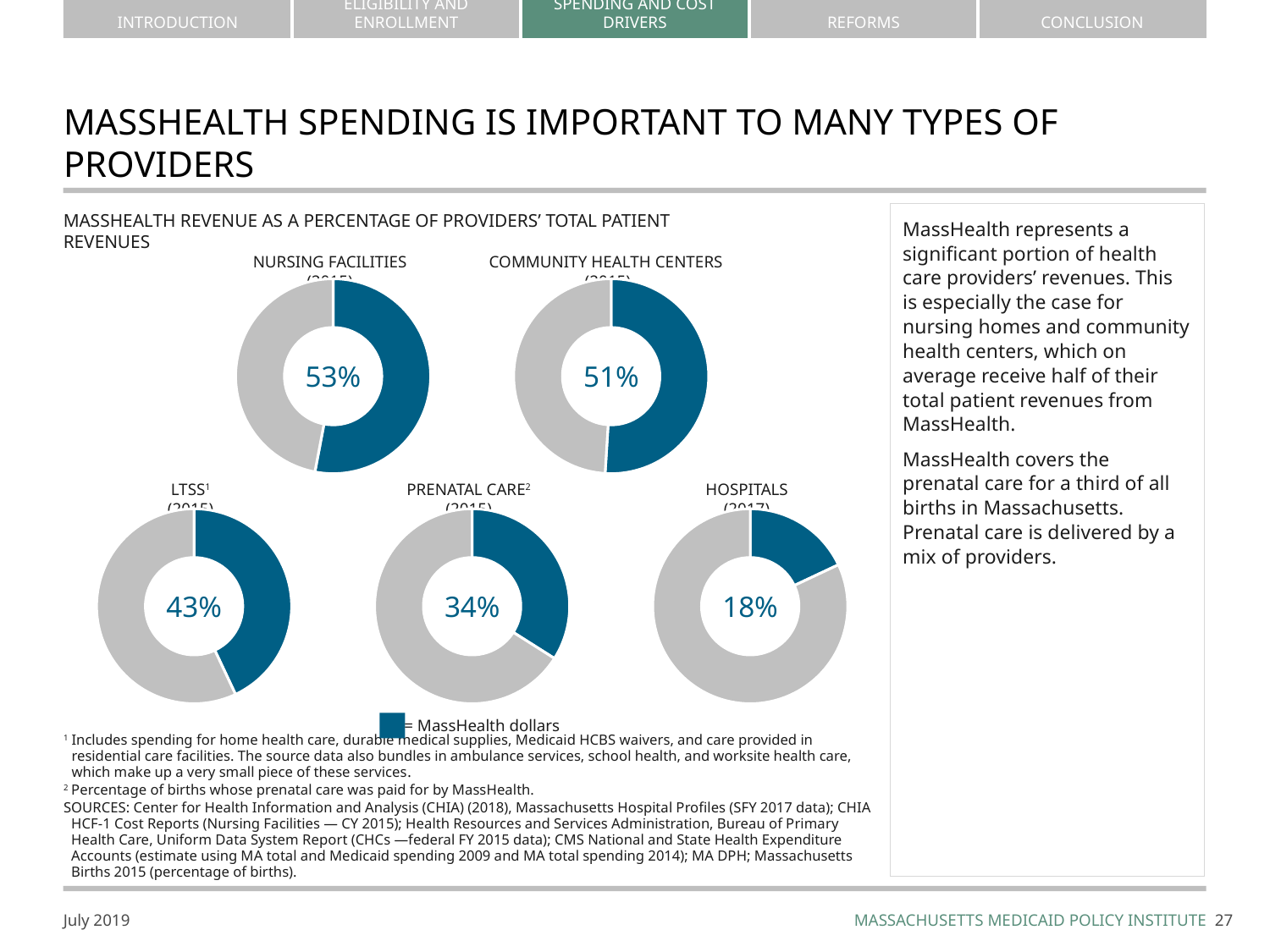
In the LTSS donut chart, what percentage of revenues is attributed to MassHealth? 43% Across the five donut charts, which provider type has the highest MassHealth share of revenues? Nursing Facilities What is the difference in percentage points between the Nursing Facilities chart and the Hospitals chart? 35 According to the legend below the charts, what does the blue segment represent? MassHealth dollars In the Nursing Facilities donut chart, what percentage of total patient revenues comes from MassHealth? 53% In the Hospitals donut chart, what percentage of total patient revenues comes from MassHealth? 18% What type of chart is used to show MassHealth revenue as a percentage of providers' total patient revenues? Donut (pie) chart In the Prenatal Care donut chart, what percentage is shown? 34% How many donut charts are shown on the slide? 5 Which is larger: the MassHealth share for LTSS or for Prenatal Care? LTSS In the Community Health Centers donut chart, what percentage is shown in the center? 51% Across the five donut charts, which provider type has the lowest MassHealth share of revenues? Hospitals